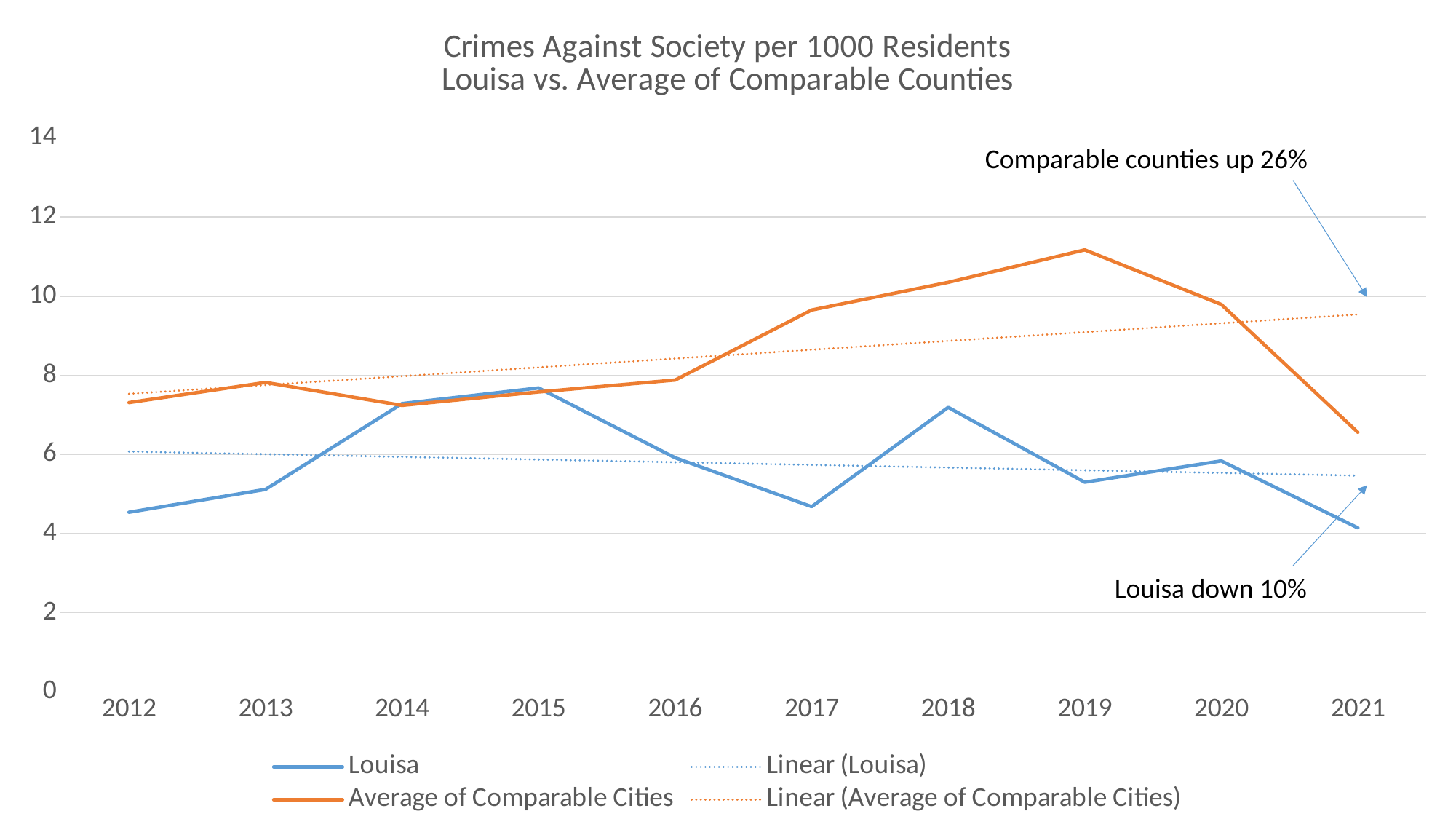
Is the value for Average of Comparable Cities in 2019 greater or less than 10? greater Is the value for Louisa in 2017 greater or less than 6? less According to the annotation on the chart, by what percentage is Louisa down? 10% How many years are shown on the x axis? 10 In which year does the Average of Comparable Cities line reach its highest value? 2019 How many entries does the legend list? 4 In 2019, which series has the larger value, Louisa or Average of Comparable Cities? Average of Comparable Cities Is the value for Average of Comparable Cities in 2017 greater or less than 8? greater What kind of chart is shown on the slide? line chart In which year does the Average of Comparable Cities line reach its lowest value? 2021 Does the Linear (Average of Comparable Cities) trend line rise or fall from 2012 to 2021? rise